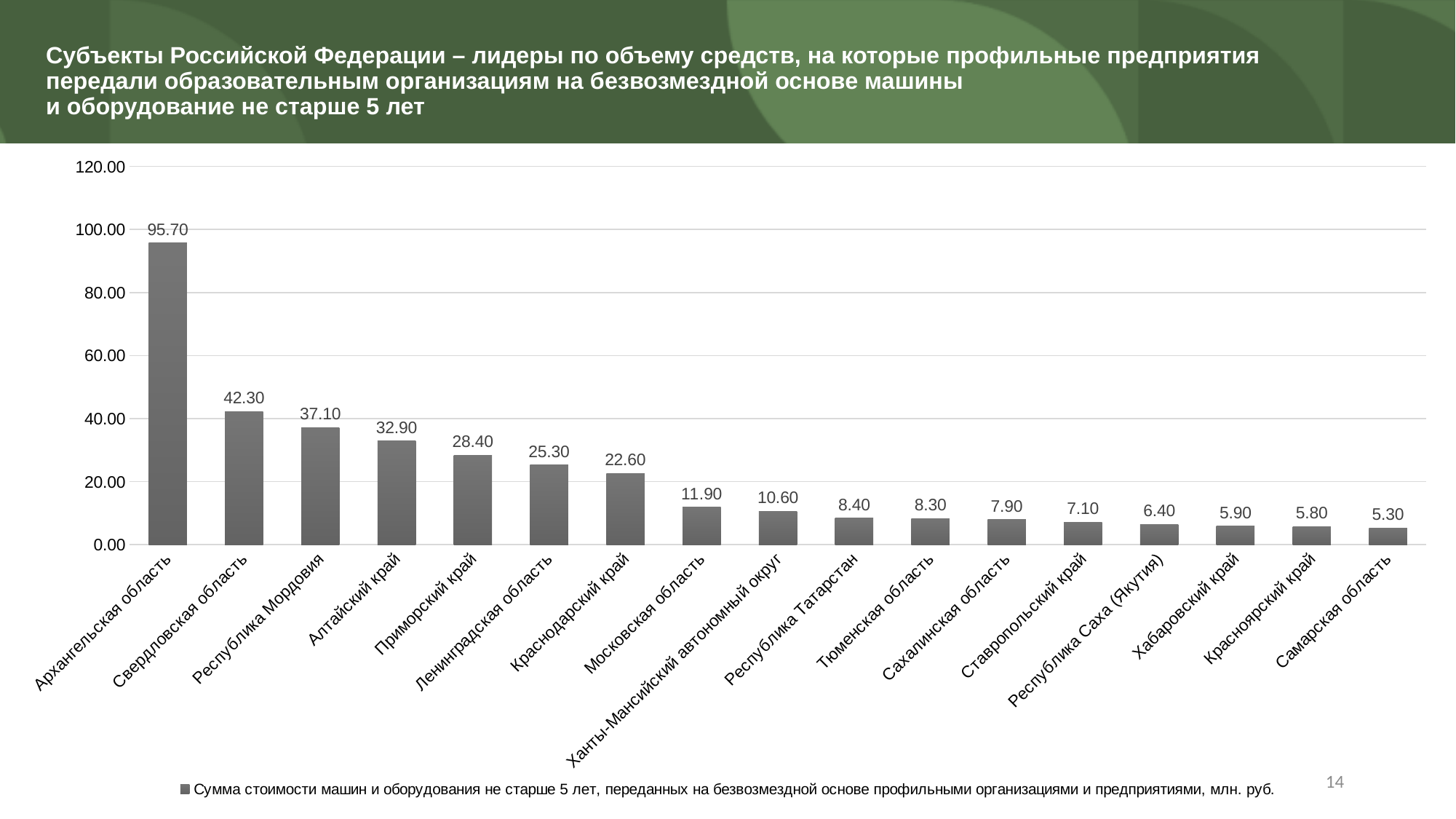
What is the value for Приморский край? 28.40 Which is larger, the value for Краснодарский край or the value for Московская область? Краснодарский край What is the value for Республика Татарстан? 8.40 Which region has the lowest value? Самарская область Which region has the highest value? Архангельская область How many regions are shown on the chart? 17 How many series does the legend list? 1 What is the difference between the values for Свердловская область and Республика Мордовия? 5.20 Is the value for Алтайский край greater or less than 40.00? less Do the values rise or fall from left to right along the x axis? fall What kind of chart is shown on the slide? bar chart What is the value for Архангельская область? 95.70